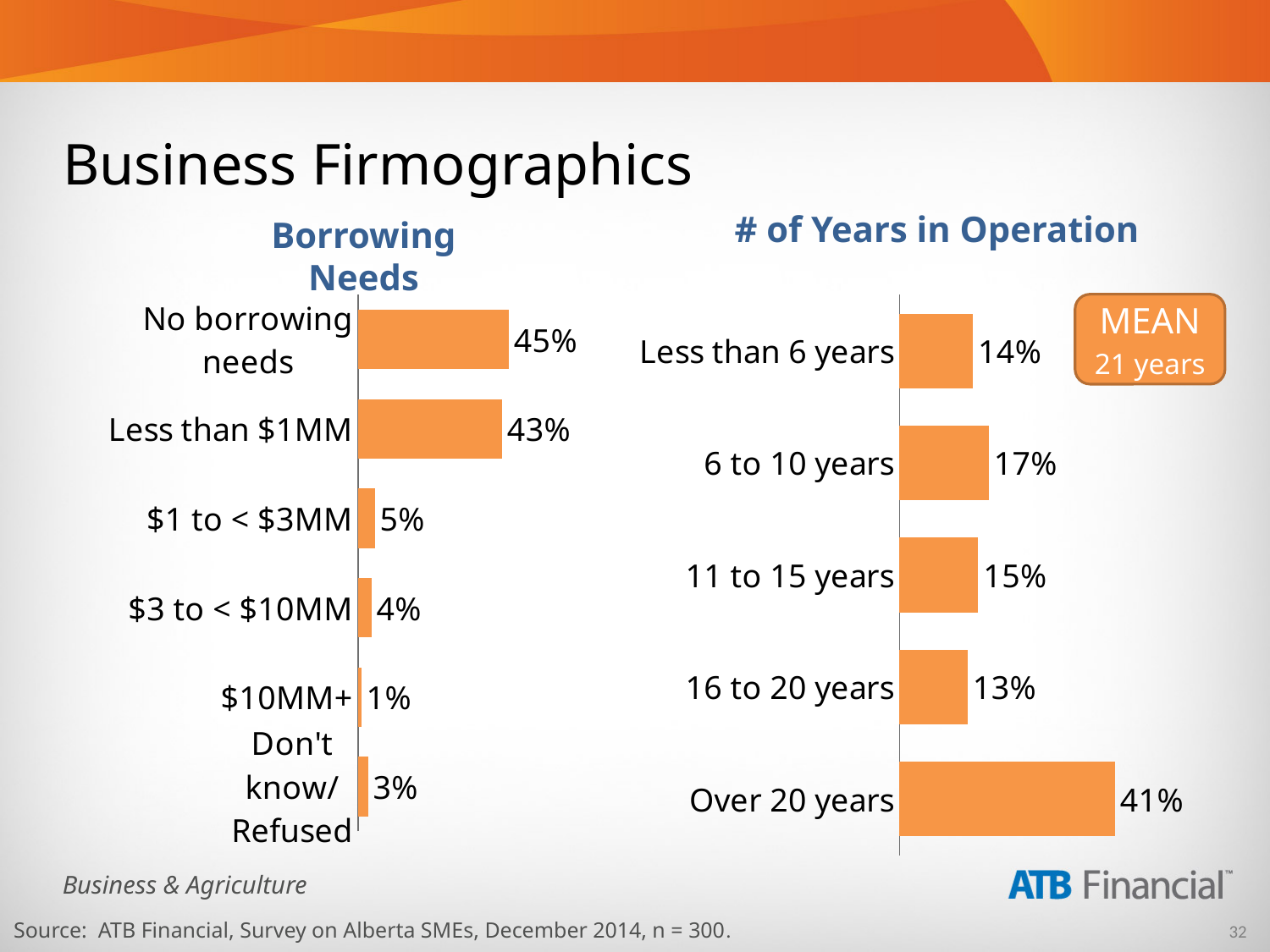
In the # of Years in Operation chart, what is the difference between Over 20 years and Less than 6 years? 27% In the Borrowing Needs chart, what is the value for $3 to < $10MM? 4% In the Borrowing Needs chart, what is the difference between No borrowing needs and Less than $1MM? 2% In the # of Years in Operation chart, what mean value is shown in the callout box? 21 years What kind of chart is the # of Years in Operation chart? Bar chart In the Borrowing Needs chart, how many categories are shown? 6 In the Borrowing Needs chart, which category has the lowest value? $10MM+ In the # of Years in Operation chart, which category has the lowest value? 16 to 20 years In the # of Years in Operation chart, which category has the highest value? Over 20 years In the # of Years in Operation chart, which is larger: 11 to 15 years or 16 to 20 years? 11 to 15 years In the # of Years in Operation chart, what is the value for 6 to 10 years? 17% In the Borrowing Needs chart, what is the value for No borrowing needs? 45%